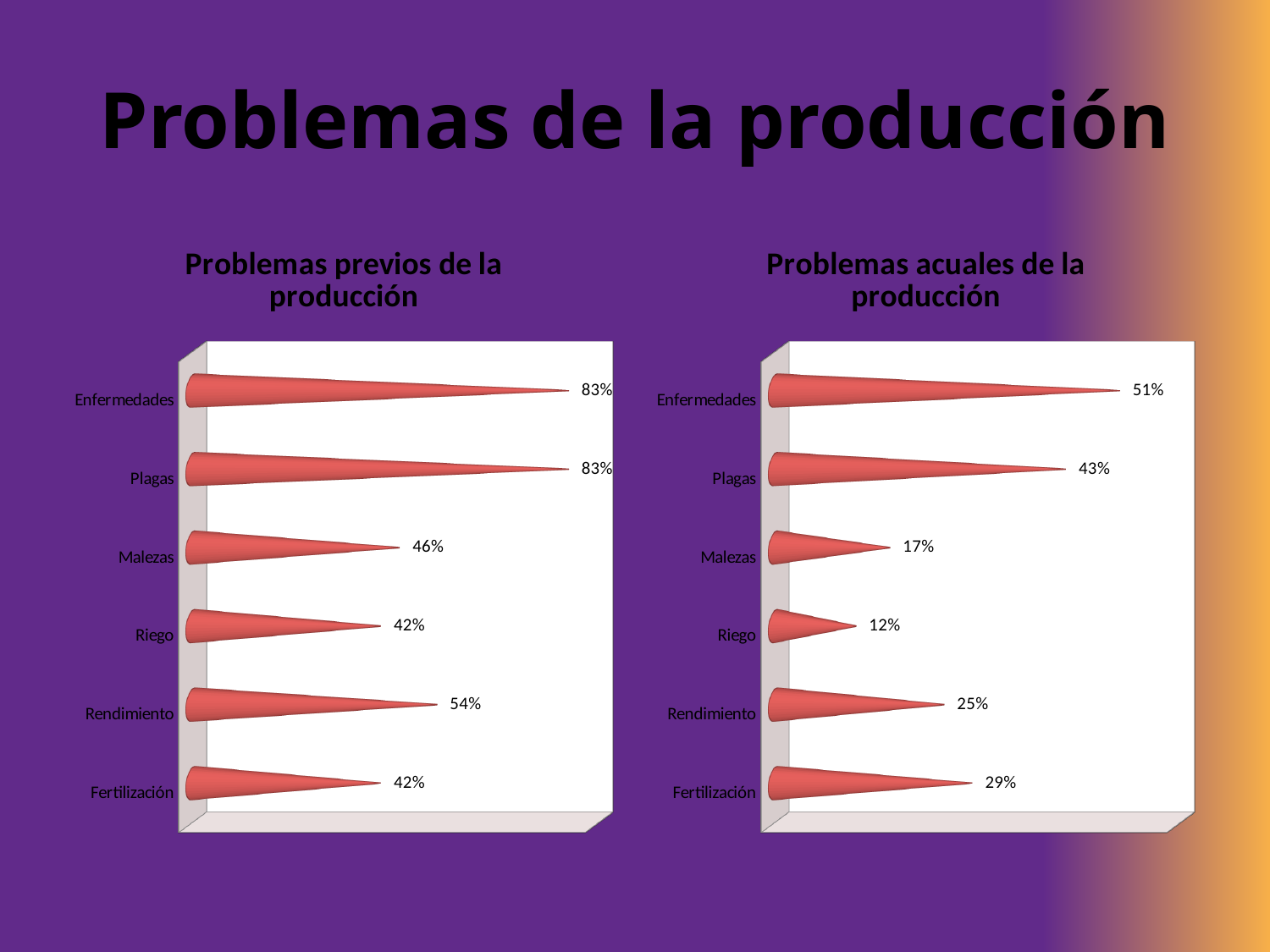
In the 'Problemas previos de la producción' chart, what is the value for Rendimiento? 54% In the 'Problemas acuales de la producción' chart, what is the value for Plagas? 43% In the 'Problemas acuales de la producción' chart, what is the value for Fertilización? 29% In the 'Problemas acuales de la producción' chart, what is the difference between the values for Enfermedades and Riego? 39% How many categories are shown in the 'Problemas previos de la producción' chart? 6 In the 'Problemas previos de la producción' chart, which is larger, the value for Rendimiento or the value for Riego? Rendimiento In the 'Problemas previos de la producción' chart, what is the difference between the values for Enfermedades and Malezas? 37% In the 'Problemas acuales de la producción' chart, which category has the lowest value? Riego In the 'Problemas acuales de la producción' chart, which category has the highest value? Enfermedades In the 'Problemas previos de la producción' chart, what is the value for Malezas? 46% What kind of chart is the 'Problemas acuales de la producción' chart? Bar chart In the 'Problemas acuales de la producción' chart, which is larger, the value for Fertilización or the value for Rendimiento? Fertilización